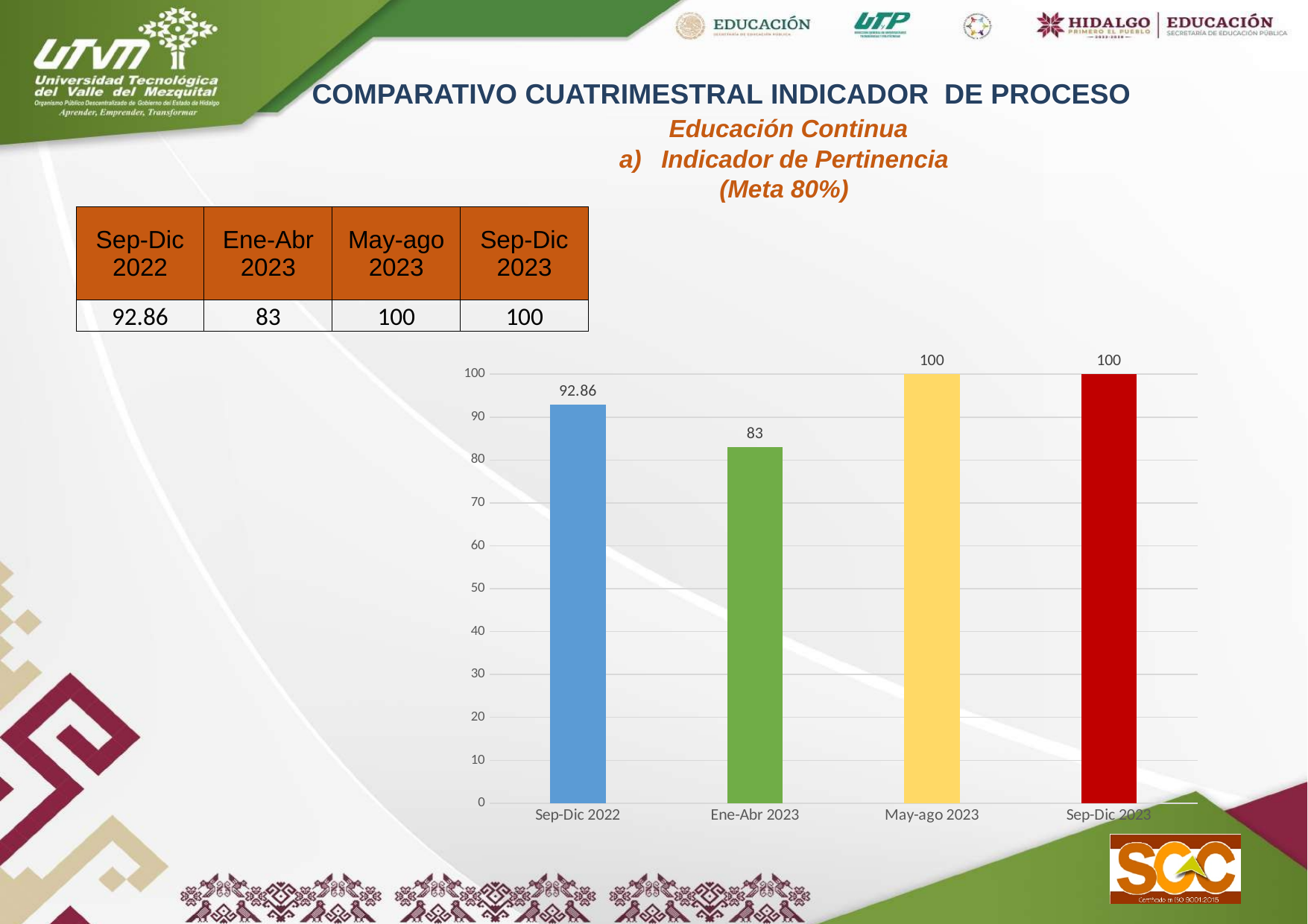
What is the value for Ene-Abr 2023? 83 How many periods are shown on the x axis of the chart? 4 What is the value for May-ago 2023? 100 What colour is the bar for Sep-Dic 2023? red Which is larger, the value for Sep-Dic 2022 or the value for Ene-Abr 2023? Sep-Dic 2022 What kind of chart is shown on the slide? bar chart What is the difference between the values for Sep-Dic 2022 and Ene-Abr 2023? 9.86 Is the value for Ene-Abr 2023 greater or less than 90? less What is the difference between the values for May-ago 2023 and Ene-Abr 2023? 17 Does the value rise or fall from Ene-Abr 2023 to May-ago 2023? rise What is the value for Sep-Dic 2022? 92.86 Which period has the lowest value? Ene-Abr 2023